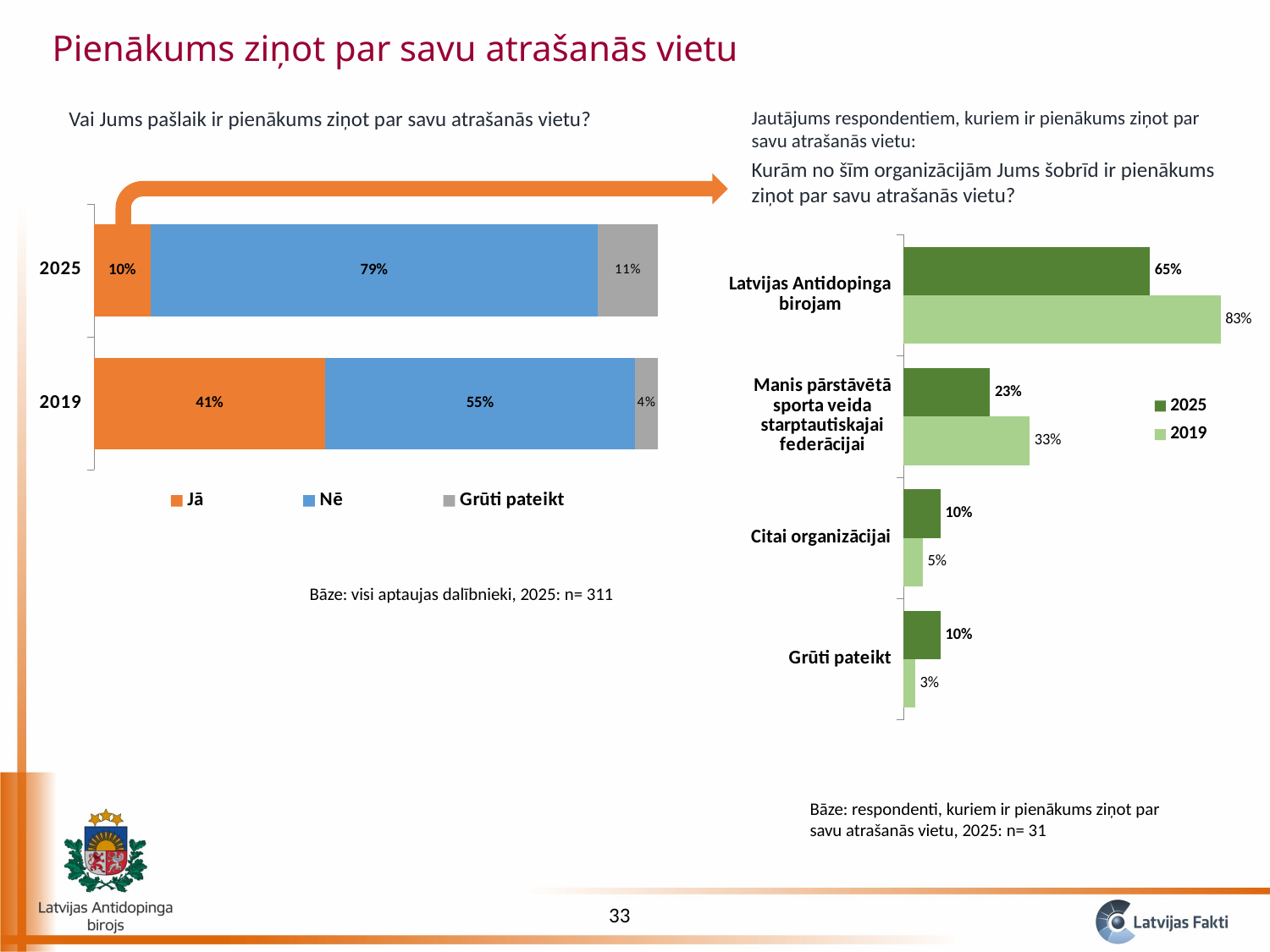
In the left chart, by how many percentage points did the "Jā" share fall from 2019 to 2025? 31 What kind of chart is the left chart? Stacked bar chart In the right chart, how many categories are shown? 4 In the left chart, what is the value for "Grūti pateikt" in 2025? 11% In the right chart, which category has the highest 2025 value? Latvijas Antidopinga birojam In the left chart ("Vai Jums pašlaik ir pienākums ziņot par savu atrašanās vietu?"), what is the value for "Jā" in 2025? 10% In the left chart, what is the value for "Nē" in 2019? 55% In the right chart, what is the difference between the 2019 and 2025 values for "Latvijas Antidopinga birojam"? 18 percentage points In the right chart ("Kurām no šīm organizācijām..."), what is the 2025 value for "Latvijas Antidopinga birojam"? 65% In the right chart, what is the 2019 value for "Manis pārstāvētā sporta veida starptautiskajai federācijai"? 33% In the left chart, how many series does the legend list? 3 In the right chart, which category has the lowest 2019 value? Grūti pateikt